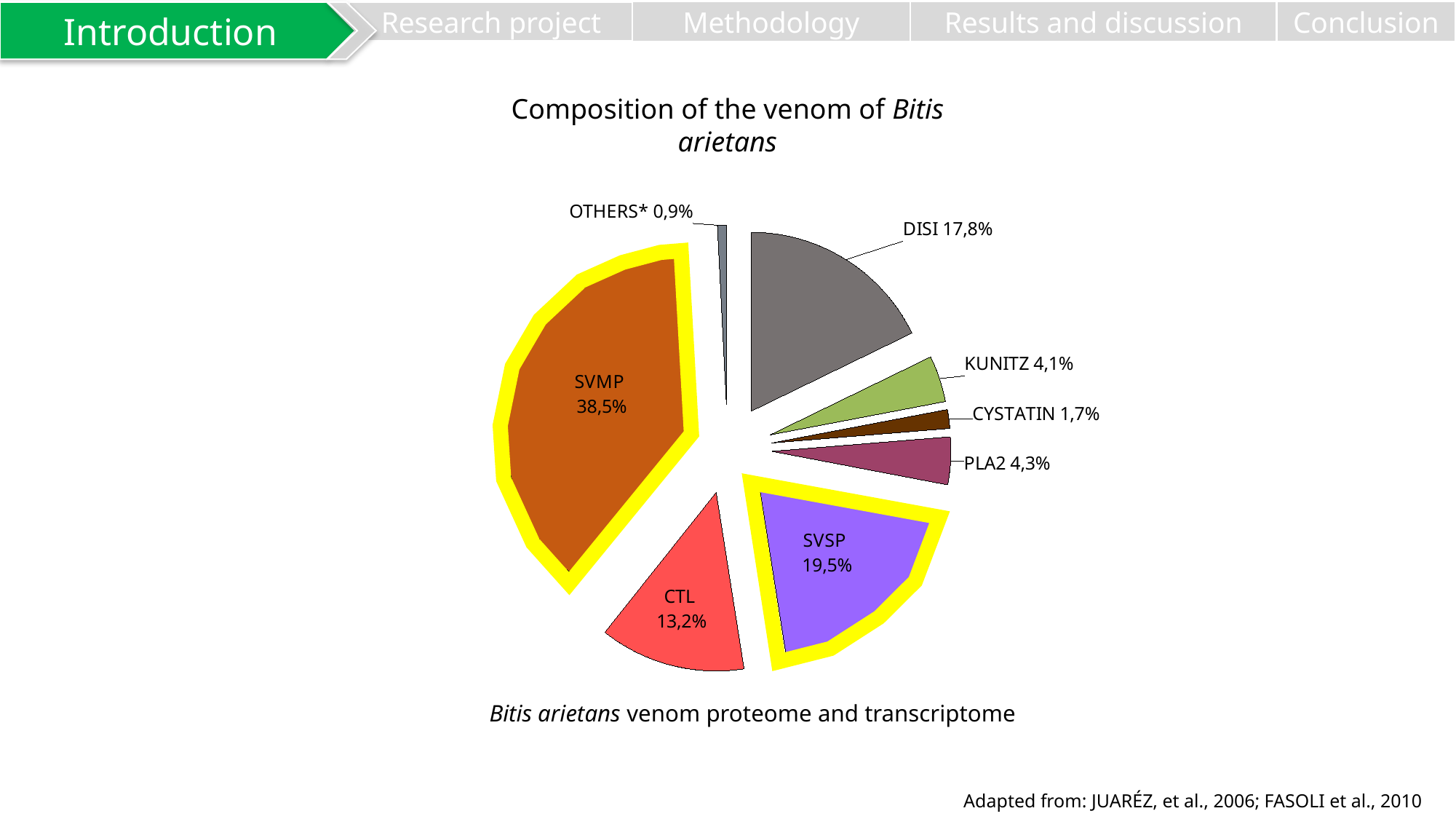
What is the share of SVMP in the venom composition pie chart? 38,5% Which slice has the smallest share in the pie chart? OTHERS* What percentage is labelled for CYSTATIN? 1,7% Which component has the largest share of the venom? SVMP What kind of chart is shown on the slide? pie chart What is the title of the chart? Composition of the venom of Bitis arietans Which is larger, the share of KUNITZ or the share of PLA2? PLA2 Which two slices are outlined in yellow? SVMP and SVSP What is the difference in percentage points between SVSP and CTL? 6,3 What percentage does the DISI slice represent? 17,8% What is the value shown for CTL? 13,2% How many slices does the pie chart have? 8